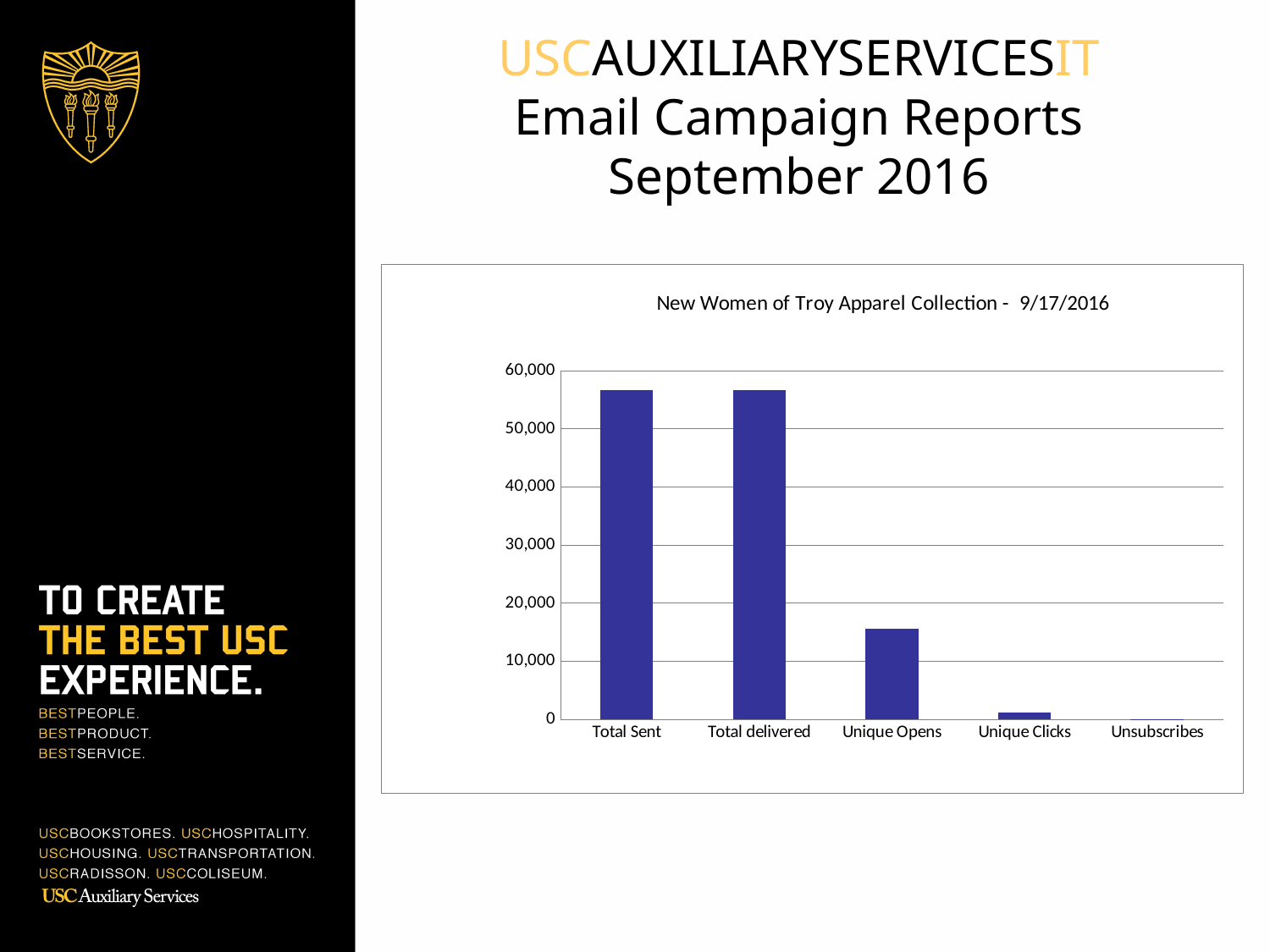
Is the value for Unique Clicks greater or less than 10,000? less Is the value for Unique Opens greater or less than 10,000? greater Which is larger, the value for Total Sent or the value for Unique Opens? Total Sent Is the value for Total Sent greater or less than 50,000? greater Which category has the lowest value in the chart? Unsubscribes What kind of chart is shown on the slide? bar chart What is the title of the chart? New Women of Troy Apparel Collection - 9/17/2016 Do the values generally rise or fall moving from left to right along the x axis? fall Which is larger, the value for Unique Opens or the value for Unique Clicks? Unique Opens How many categories are shown on the x axis of the chart? 5